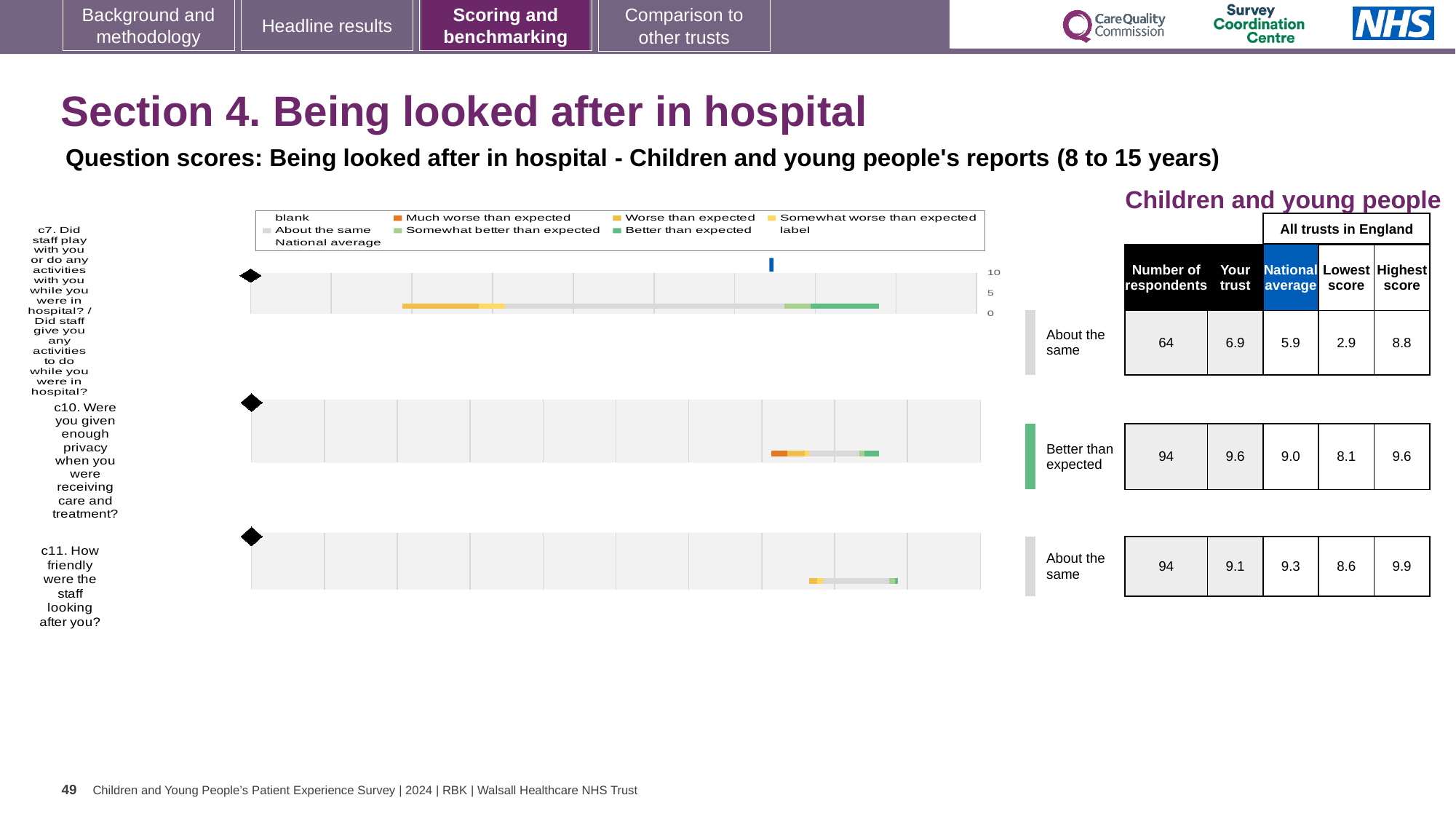
For question c7 (Did staff play with you or do any activities with you), what is the 'Your trust' score? 6.9 For question c11 (How friendly were the staff looking after you), what is the highest score among all trusts in England? 9.9 How many respondents answered question c7? 64 For question c10 (Were you given enough privacy), what is the national average score? 9.0 Which question has the highest 'Your trust' score? c10 For question c11, which is larger: the 'Your trust' score or the national average? National average What kind of chart is used to show the question scores for c7, c10 and c11? bar chart How many questions (c7, c10, c11) are plotted on the slide? 3 For question c7, what is the difference between the 'Your trust' score and the national average? 1.0 Which question has the lowest 'Lowest score' among all trusts in England? c7 For question c10, what is the difference between the highest score and the lowest score among all trusts in England? 1.5 What benchmark category is shown for question c10? Better than expected